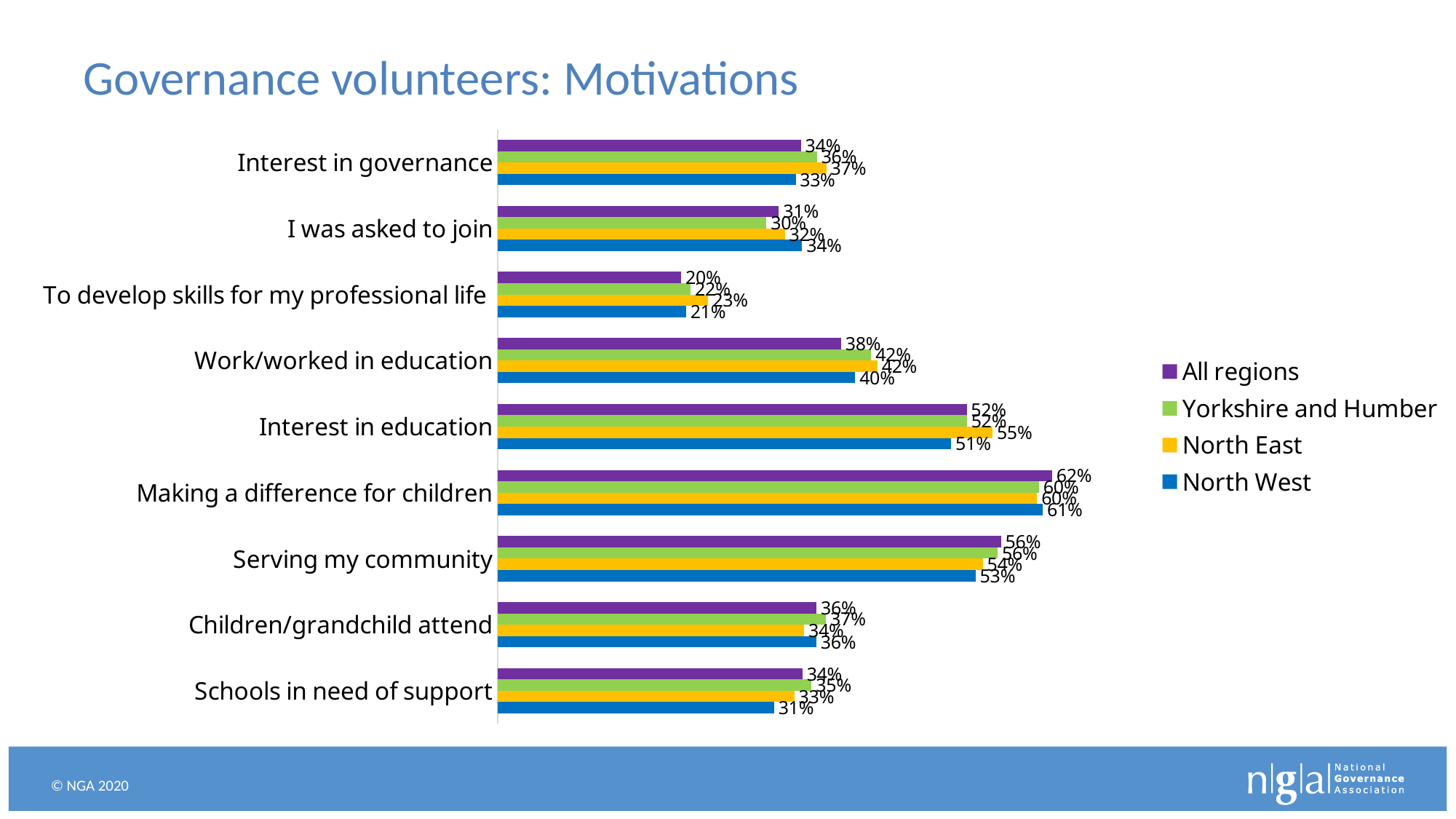
What kind of chart is shown on the slide? Bar chart What is the value for All regions for 'Making a difference for children'? 62% What is the value for North East for 'Interest in education'? 55% Which motivation has the highest value for All regions? Making a difference for children What is the value for North West for 'Schools in need of support'? 31% How many series does the legend list? 4 Which motivation has the lowest value for North West? To develop skills for my professional life How many motivation categories are plotted on the chart? 9 What is the value for Yorkshire and Humber for 'To develop skills for my professional life'? 22% What is the difference between the All regions value for 'Making a difference for children' and the All regions value for 'Serving my community'? 6% Which colour represents North East in the legend? Yellow For 'Work/worked in education', which is larger: the All regions value or the North West value? North West